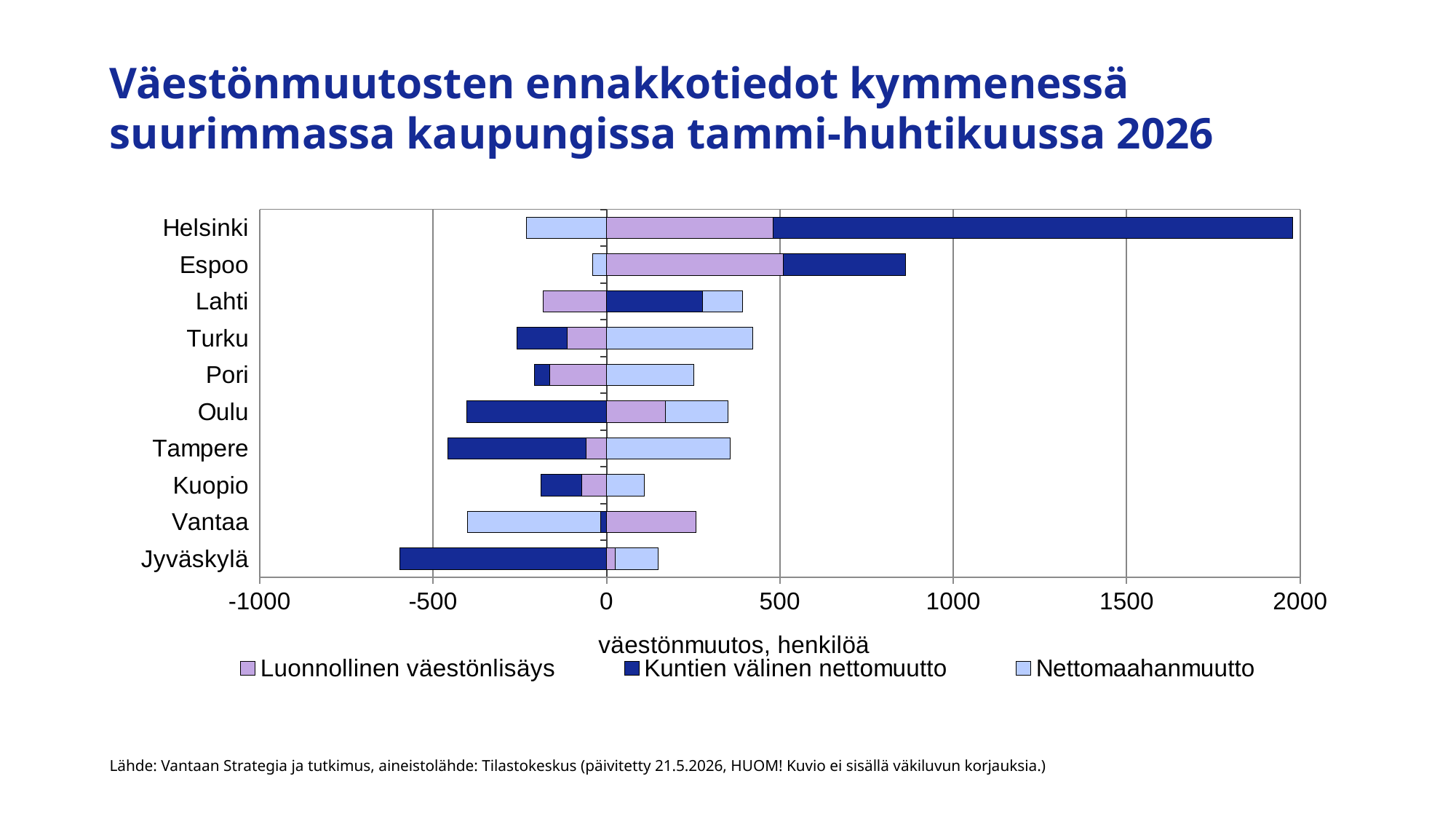
How many series does the legend list? 3 How many cities are shown on the chart? 10 What kind of chart is shown on the slide? bar chart Which city has the largest Nettomaahanmuutto value? Turku What is the label of the horizontal axis? väestönmuutos, henkilöä Is the Kuntien välinen nettomuutto value for Jyväskylä greater or less than -500? less Is the Kuntien välinen nettomuutto value for Helsinki greater or less than 1000? greater Which is larger, the Kuntien välinen nettomuutto value for Helsinki or for Espoo? Helsinki Which city has the most negative Kuntien välinen nettomuutto value? Jyväskylä Which legend entry is shown in dark blue? Kuntien välinen nettomuutto Which city has the largest Kuntien välinen nettomuutto value? Helsinki Is the Nettomaahanmuutto value for Turku greater or less than 500? less